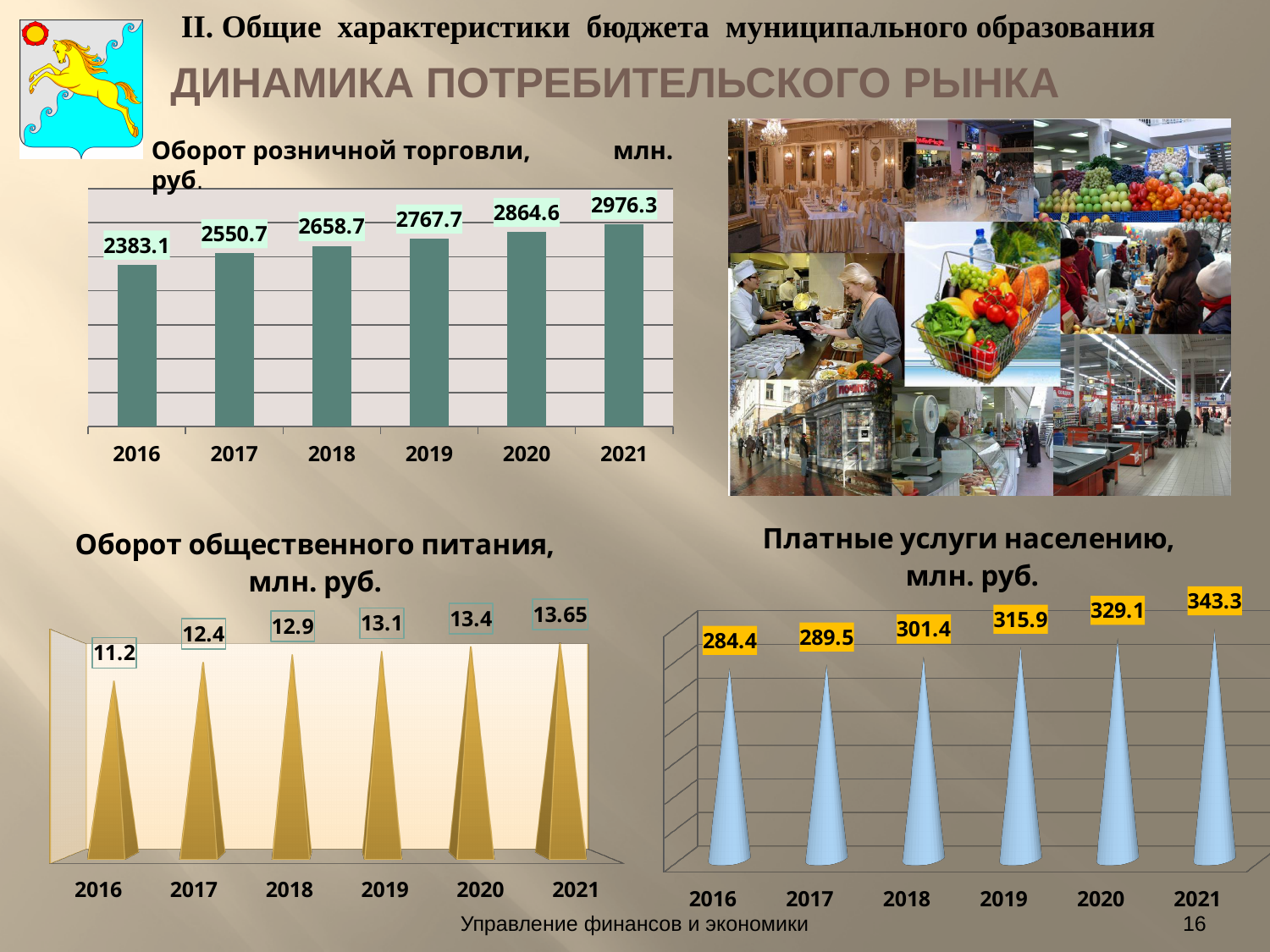
In the chart 'Платные услуги населению, млн. руб.', what is the difference between the 2021 and 2020 values? 14.2 What kind of chart is 'Оборот розничной торговли, млн. руб.'? bar chart In the chart 'Платные услуги населению, млн. руб.', which is larger, the value for 2018 or the value for 2019? 2019 In the chart 'Оборот розничной торговли, млн. руб.', what is the value for 2019? 2767.7 In the chart 'Оборот общественного питания, млн. руб.', what is the difference between the 2017 and 2016 values? 1.2 In the chart 'Оборот общественного питания, млн. руб.', what is the value for 2018? 12.9 In the chart 'Платные услуги населению, млн. руб.', what is the value for 2020? 329.1 In the chart 'Оборот розничной торговли, млн. руб.', what is the difference between the 2021 and 2016 values? 593.2 In the chart 'Оборот розничной торговли, млн. руб.', which year has the highest value? 2021 In the chart 'Оборот розничной торговли, млн. руб.', do the values rise or fall from 2016 to 2021? rise In the chart 'Оборот общественного питания, млн. руб.', how many years are shown? 6 In the chart 'Оборот общественного питания, млн. руб.', which year has the lowest value? 2016